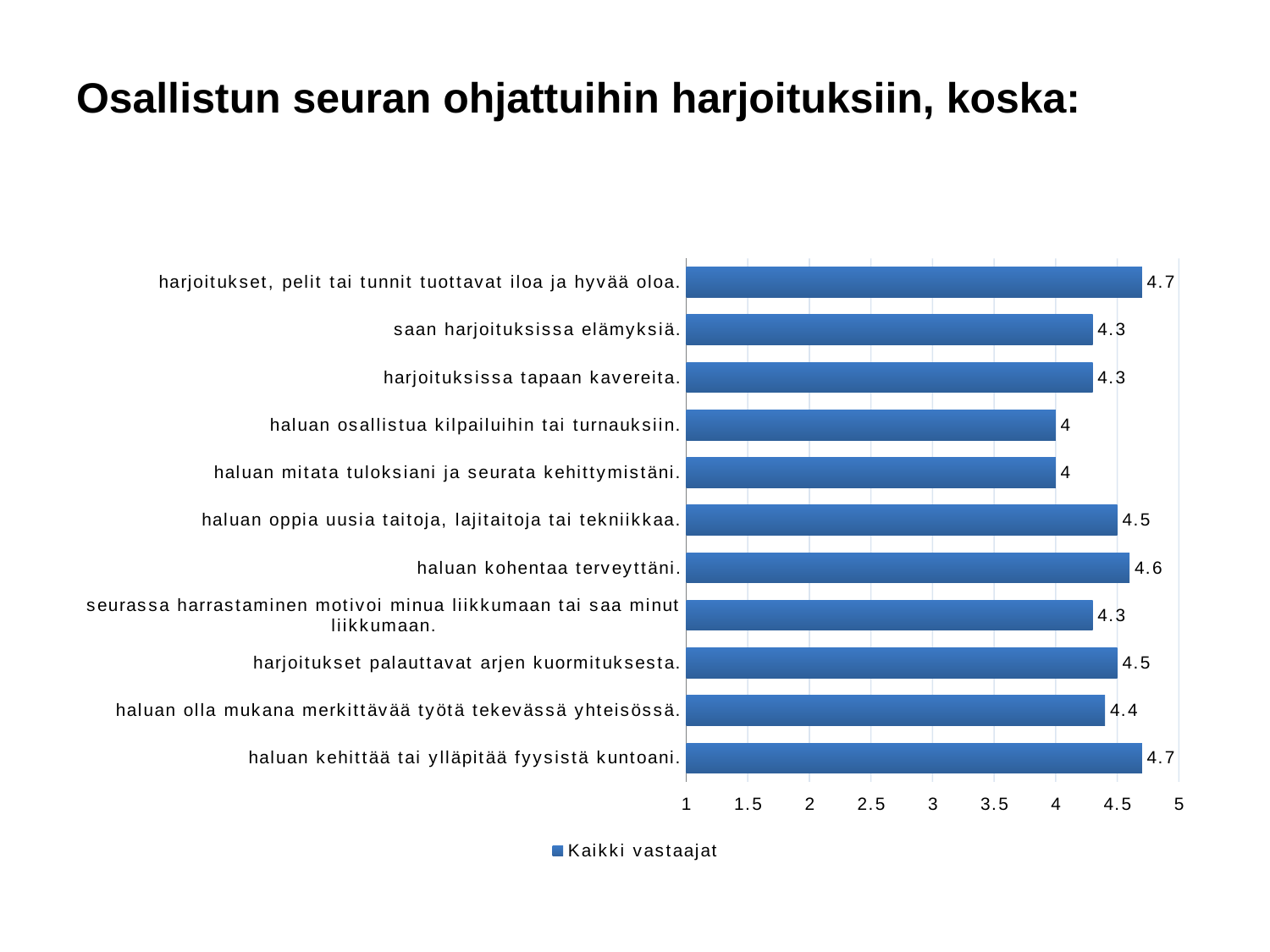
What is the highest value shown on the chart? 4.7 What is the value for "haluan olla mukana merkittävää työtä tekevässä yhteisössä."? 4.4 What is the name of the series in the legend? Kaikki vastaajat What kind of chart is shown on the slide? Bar chart Which has a larger value: "haluan kohentaa terveyttäni." or "harjoituksissa tapaan kavereita."? haluan kohentaa terveyttäni. What is the value for "haluan kohentaa terveyttäni."? 4.6 What is the lowest value shown on the chart? 4 What is the value for "haluan osallistua kilpailuihin tai turnauksiin."? 4 What is the value for "saan harjoituksissa elämyksiä."? 4.3 How many series does the legend list? 1 What is the difference between the values for "haluan kehittää tai ylläpitää fyysistä kuntoani." and "haluan mitata tuloksiani ja seurata kehittymistäni."? 0.7 How many categories are shown on the chart? 11